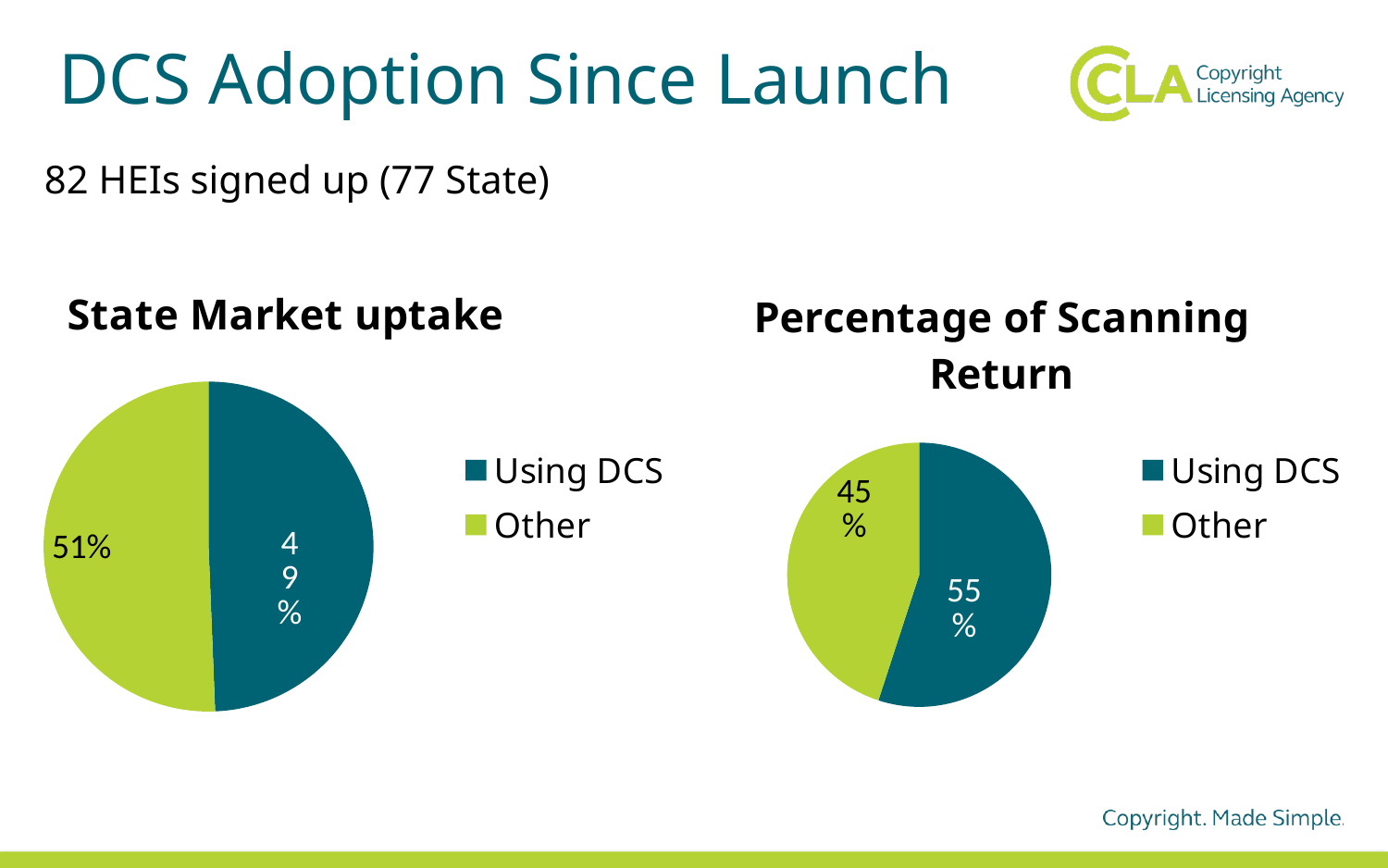
In the 'Percentage of Scanning Return' chart, what percentage is shown for Using DCS? 55% What type of chart is the 'State Market uptake' chart? Pie chart In the 'Percentage of Scanning Return' chart, what is the difference between the Using DCS and Other slices? 10% In the 'Percentage of Scanning Return' chart, which slice is the smallest? Other In the 'Percentage of Scanning Return' chart, what percentage is shown for Other? 45% In the 'State Market uptake' chart, what colour is the Using DCS slice? Dark teal In the 'State Market uptake' chart, what percentage is shown for Other? 51% In the 'State Market uptake' chart, what is the difference between the Other and Using DCS slices? 2% How many entries does the legend of the 'Percentage of Scanning Return' chart list? 2 In the 'State Market uptake' chart, what percentage is shown for Using DCS? 49% In the 'State Market uptake' chart, which slice is the largest? Other In the 'Percentage of Scanning Return' chart, which slice is larger, Using DCS or Other? Using DCS